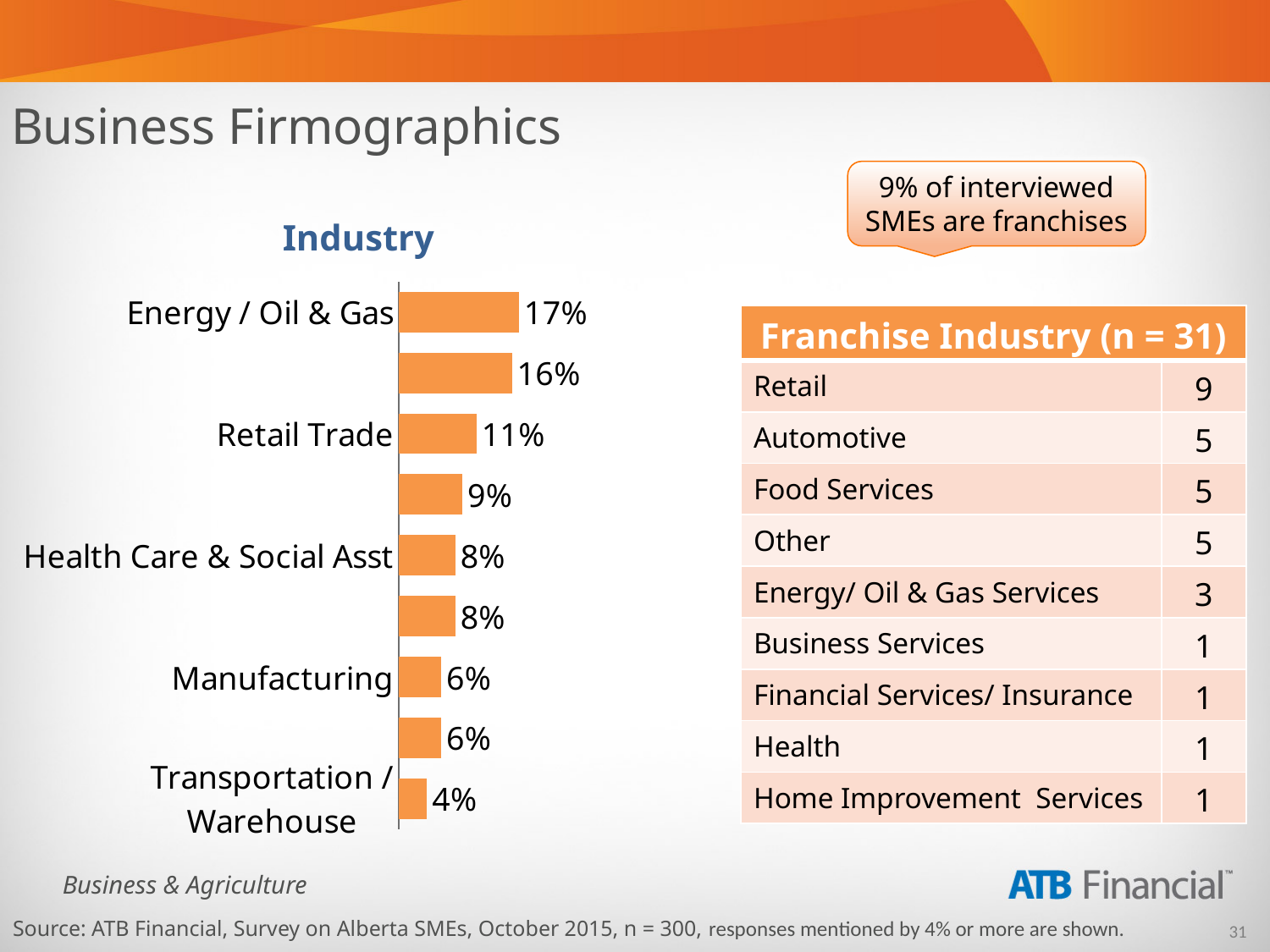
In the Industry chart, which category has the lowest value? Transportation / Warehouse In the Industry chart, what is the value for Transportation / Warehouse? 4% In the Industry chart, what is the value for Manufacturing? 6% How many bars are plotted in the Industry chart? 9 What kind of chart is the Industry chart? Bar chart In the Industry chart, what is the value for Energy / Oil & Gas? 17% In the Industry chart, which category has the highest value? Energy / Oil & Gas In the Industry chart, what is the value for Health Care & Social Asst? 8% In the Industry chart, do the values increase or decrease going from the top bar to the bottom bar? Decrease In the Industry chart, what is the value for Retail Trade? 11% In the Industry chart, what is the difference between the values for Energy / Oil & Gas and Retail Trade? 6 percentage points In the Industry chart, which is larger: Retail Trade or Manufacturing? Retail Trade